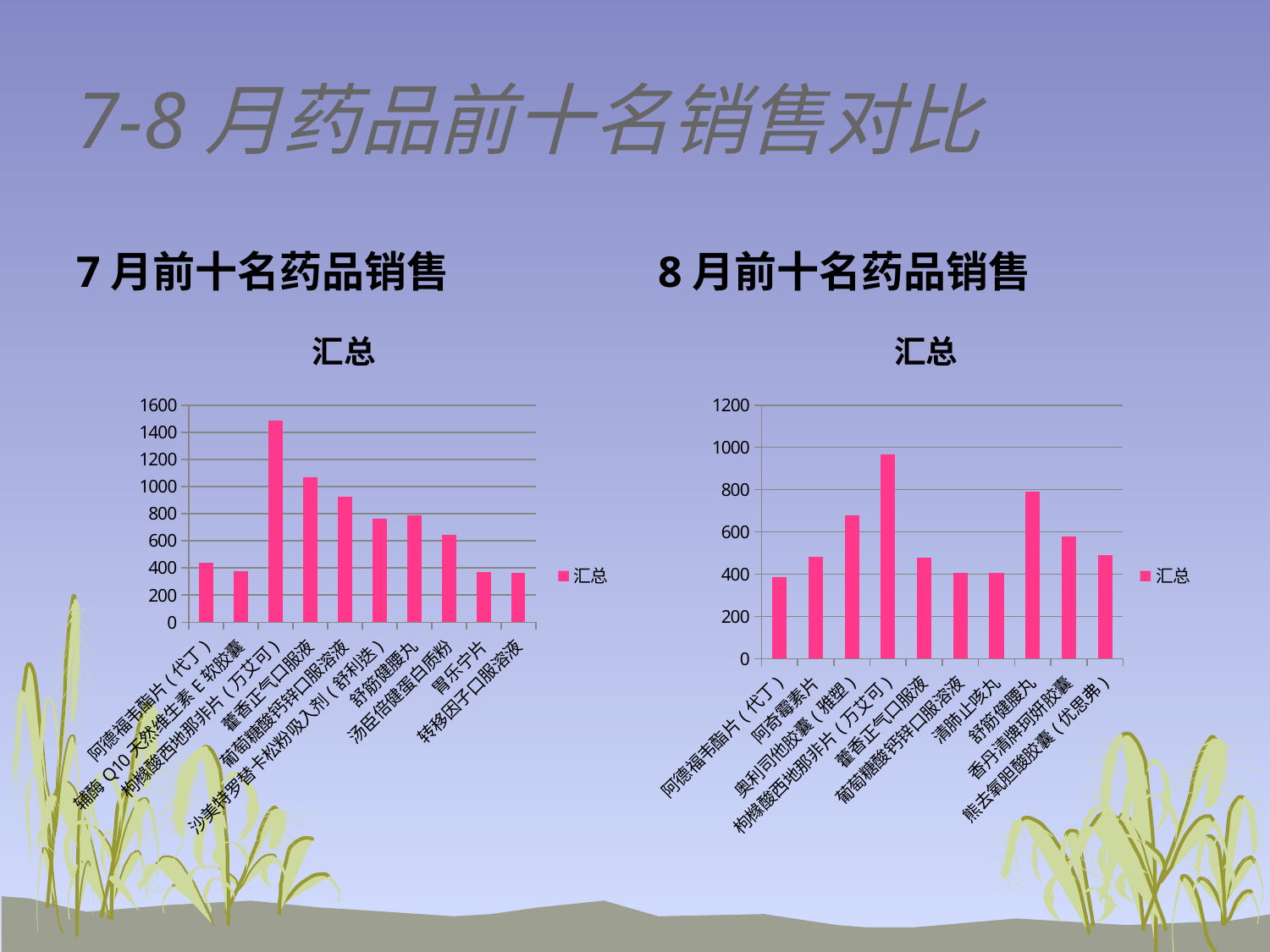
On the left chart (7月前十名药品销售), is the value for 阿德福韦酯片（代丁） greater or less than 600? less On the left chart (7月前十名药品销售), which is larger: 藿香正气口服液 or 葡萄糖酸钙锌口服溶液? 藿香正气口服液 On the right chart (8月前十名药品销售), how many drugs are plotted? 10 On the left chart (7月前十名药品销售), is the value for 藿香正气口服液 greater or less than 1000? greater On the left chart (7月前十名药品销售), how many drugs are plotted? 10 On the right chart (8月前十名药品销售), which drug has the highest sales? 枸橼酸西地那非片（万艾可） On the right chart (8月前十名药品销售), which is larger: 舒筋健腰丸 or 熊去氧胆酸胶囊（优思弗）? 舒筋健腰丸 On the left chart (7月前十名药品销售), which drug has the highest sales? 枸橼酸西地那非片（万艾可） On the right chart (8月前十名药品销售), is the value for 舒筋健腰丸 greater or less than 600? greater On the left chart (7月前十名药品销售), what kind of chart is shown? bar chart On the right chart (8月前十名药品销售), how many series does the legend list? 1